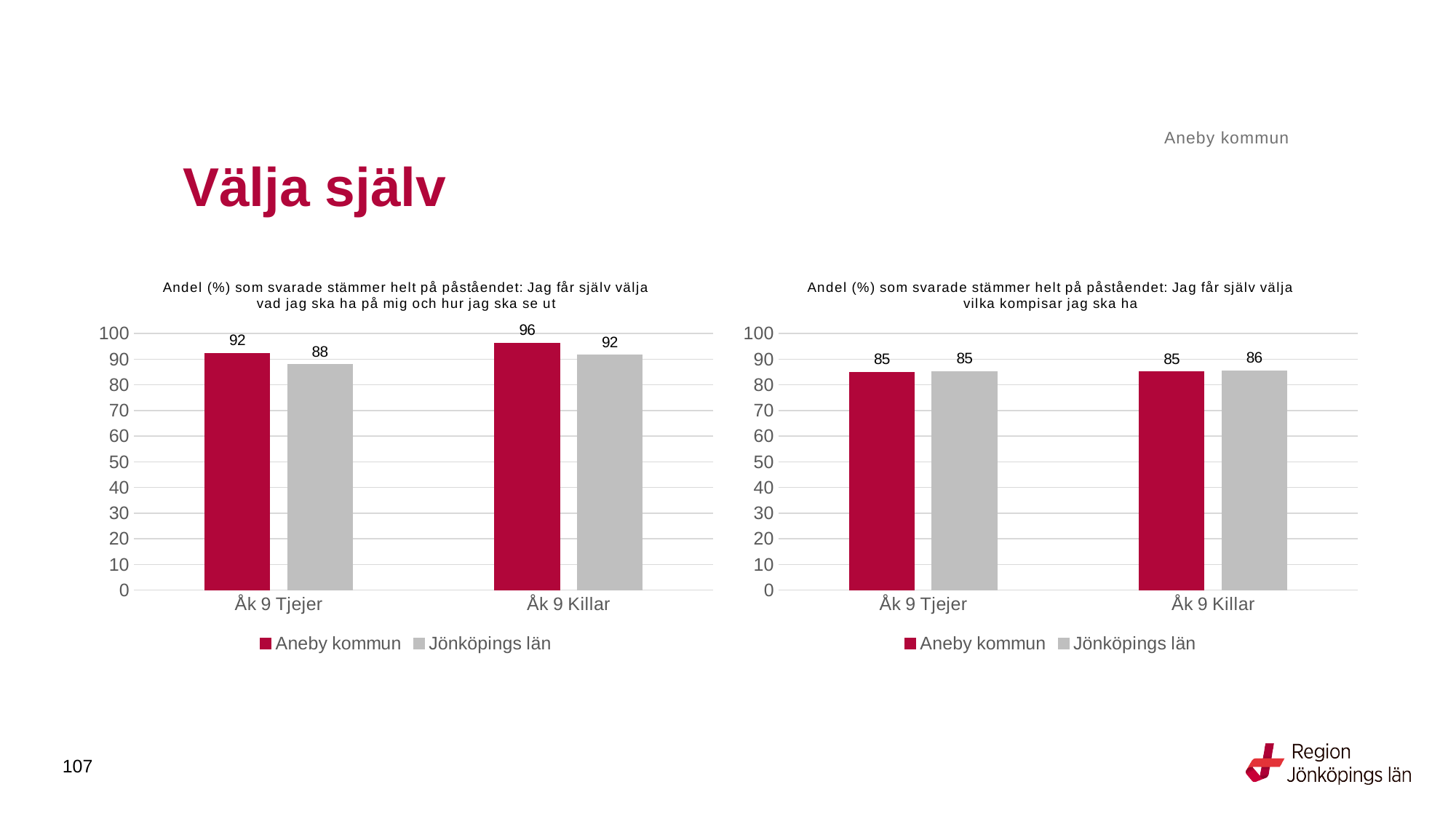
In the left chart (about choosing what to wear and how to look), which bar has the highest value? Aneby kommun, Åk 9 Killar How many series does the legend of the left chart list? 2 What kind of chart is the right chart (about choosing which friends to have)? Bar chart In the left chart (about choosing what to wear and how to look), which bar has the lowest value? Jönköpings län, Åk 9 Tjejer In the left chart (about choosing what to wear and how to look), what is the value for Aneby kommun for Åk 9 Tjejer? 92 In the left chart (about choosing what to wear and how to look), what is the value for Jönköpings län for Åk 9 Killar? 92 In the left chart (about choosing what to wear and how to look), what is the difference between Aneby kommun and Jönköpings län for Åk 9 Killar? 4 In the right chart (about choosing which friends to have), what is the difference between Jönköpings län for Åk 9 Killar and Aneby kommun for Åk 9 Killar? 1 In the left chart (about choosing what to wear and how to look), what is the difference between Aneby kommun and Jönköpings län for Åk 9 Tjejer? 4 In the right chart (about choosing which friends to have), what is the value for Jönköpings län for Åk 9 Killar? 86 In the right chart (about choosing which friends to have), what is the value for Aneby kommun for Åk 9 Tjejer? 85 How many categories are shown on the x axis of the right chart? 2